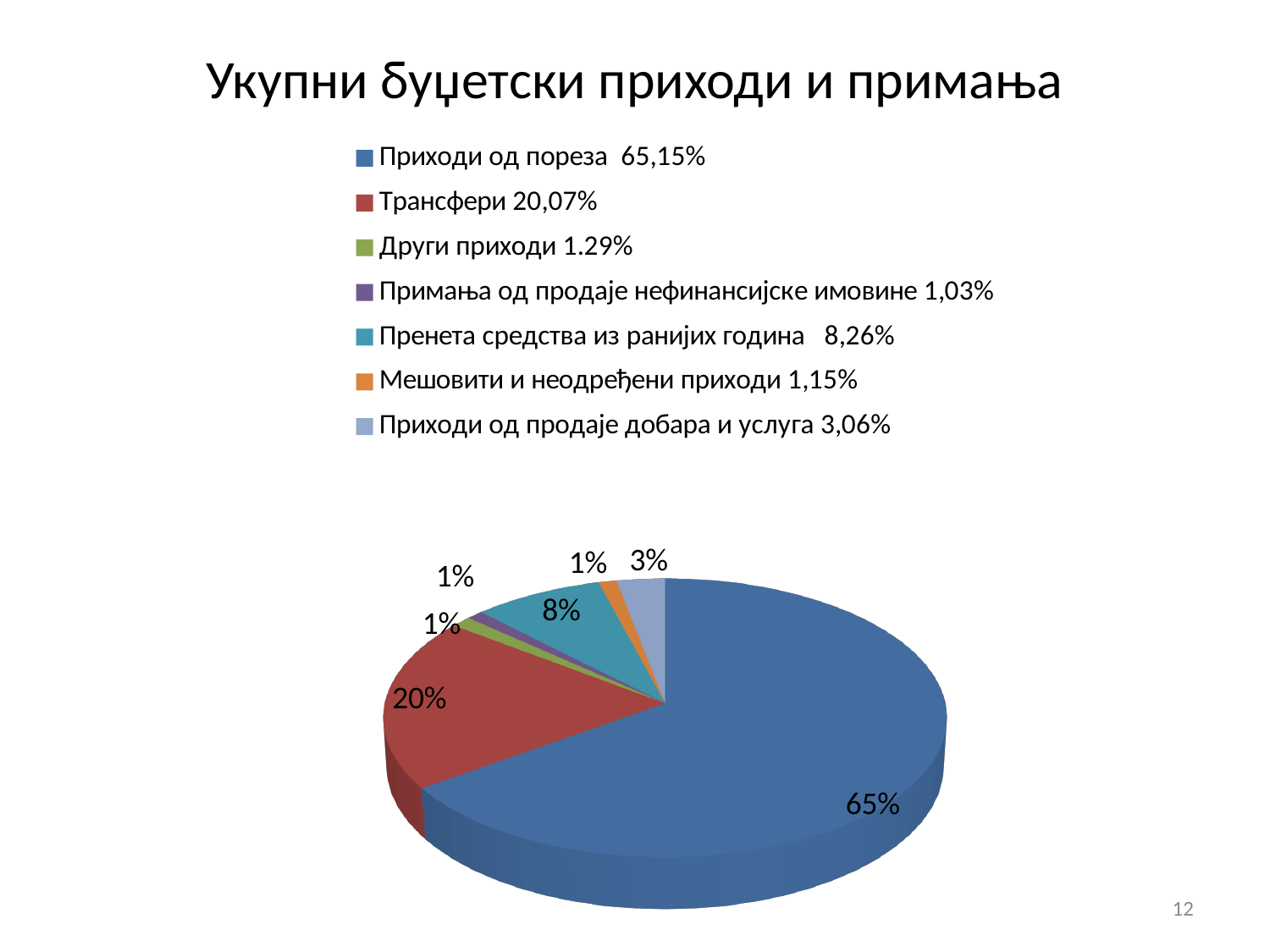
Which category has the largest share of the pie? Приходи од пореза According to the legend, what percentage is given for Приходи од пореза? 65,15% Based on the percentages in the legend, which category has the smallest share? Примања од продаје нефинансијске имовине According to the legend, what percentage is given for Пренета средства из ранијих година? 8,26% How many categories does the legend of the pie chart list? 7 What kind of chart is shown on the slide? pie chart According to the legend, what percentage is given for Приходи од продаје добара и услуга? 3,06% Which is larger: the share for Пренета средства из ранијих година or the share for Приходи од продаје добара и услуга? Пренета средства из ранијих година What data label is shown on the largest slice of the pie? 65% What is the title of the slide with the pie chart? Укупни буџетски приходи и примања According to the legend, what percentage is given for Трансфери? 20,07% Using the legend percentages, what is the difference between Приходи од пореза and Трансфери? 45,08%